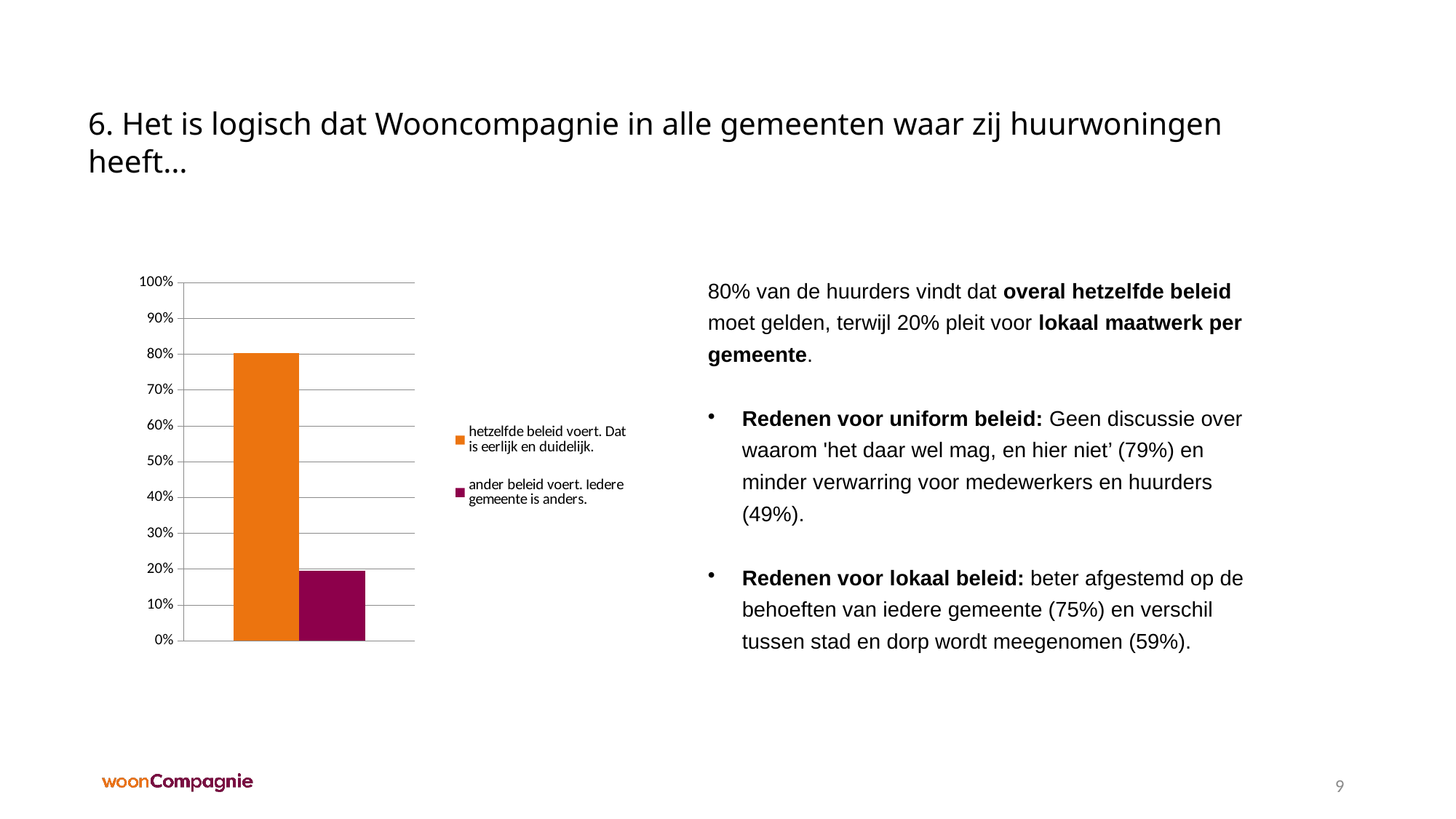
Which series has the highest bar in the chart? hetzelfde beleid voert. Dat is eerlijk en duidelijk. Is the value for 'ander beleid voert. Iedere gemeente is anders.' greater or less than 30%? less What kind of chart is shown on the slide? bar chart What colour is the bar for 'ander beleid voert. Iedere gemeente is anders.'? purple Which bar is larger: 'hetzelfde beleid voert' or 'ander beleid voert'? hetzelfde beleid voert. Dat is eerlijk en duidelijk. How many series does the chart legend list? 2 Is the value for 'hetzelfde beleid voert. Dat is eerlijk en duidelijk.' greater or less than 50%? greater How many bars are plotted in the chart? 2 Which series has the lowest bar in the chart? ander beleid voert. Iedere gemeente is anders. What is the maximum value shown on the chart's vertical axis? 100% What is the value of the bar for 'hetzelfde beleid voert. Dat is eerlijk en duidelijk.'? 80% Is the value for 'ander beleid voert. Iedere gemeente is anders.' greater or less than 10%? greater